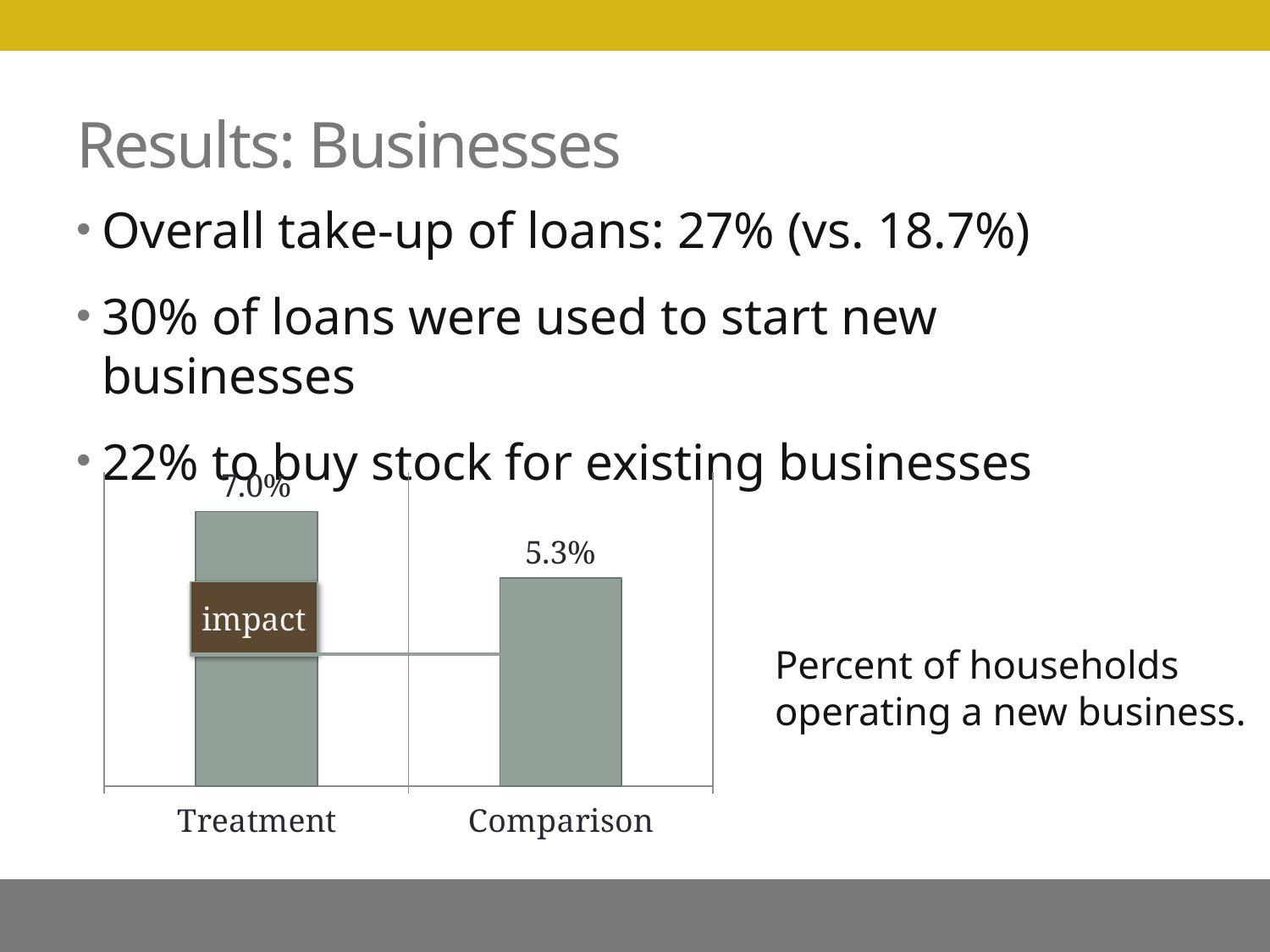
What is the value for Comparison in the chart? 5.3% Which category has the higher value in the chart? Treatment What word is written in the box overlaid on the Treatment bar? impact How many categories are shown in the chart? 2 Is the value for Treatment larger or smaller than the value for Comparison? larger What is the difference between the Treatment and Comparison values? 1.7% Which category has the lower value in the chart? Comparison What is the value for Treatment in the chart? 7.0% According to the caption next to the chart, what do the bars measure? Percent of households operating a new business What kind of chart is shown on the slide? bar chart